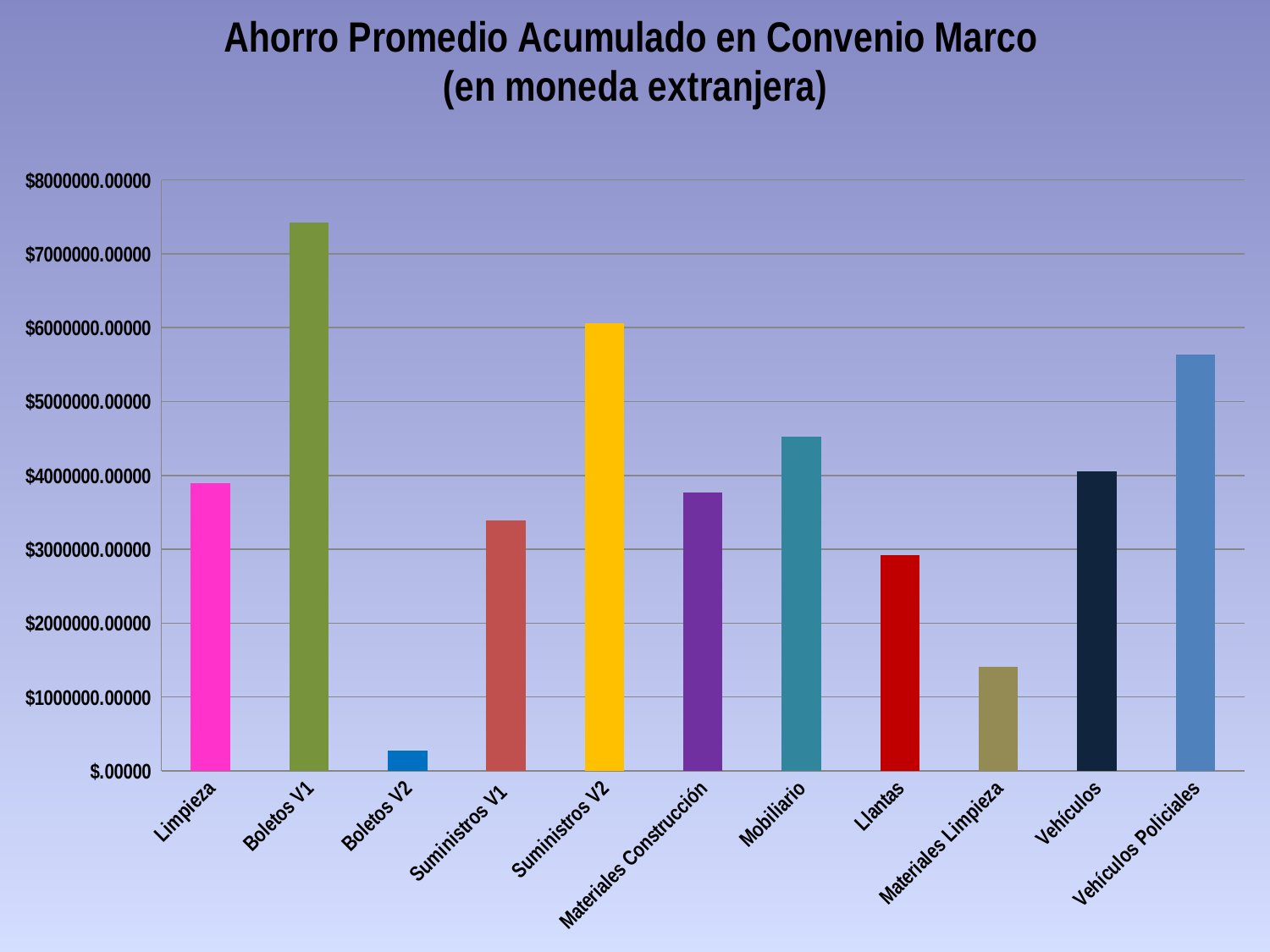
Which is larger, the value for Mobiliario or the value for Limpieza? Mobiliario Is the value for Limpieza greater or less than $4000000.00000? less Which is larger, the value for Boletos V1 or the value for Suministros V2? Boletos V1 What kind of chart is shown on the slide? bar chart Is the value for Boletos V1 greater or less than $7000000.00000? greater Is the value for Materiales Limpieza greater or less than $1000000.00000? greater What is the title of the chart? Ahorro Promedio Acumulado en Convenio Marco (en moneda extranjera) Which category has the highest value? Boletos V1 Which is larger, the value for Vehículos Policiales or the value for Mobiliario? Vehículos Policiales Which category has the lowest value? Boletos V2 How many categories are plotted on the x axis? 11